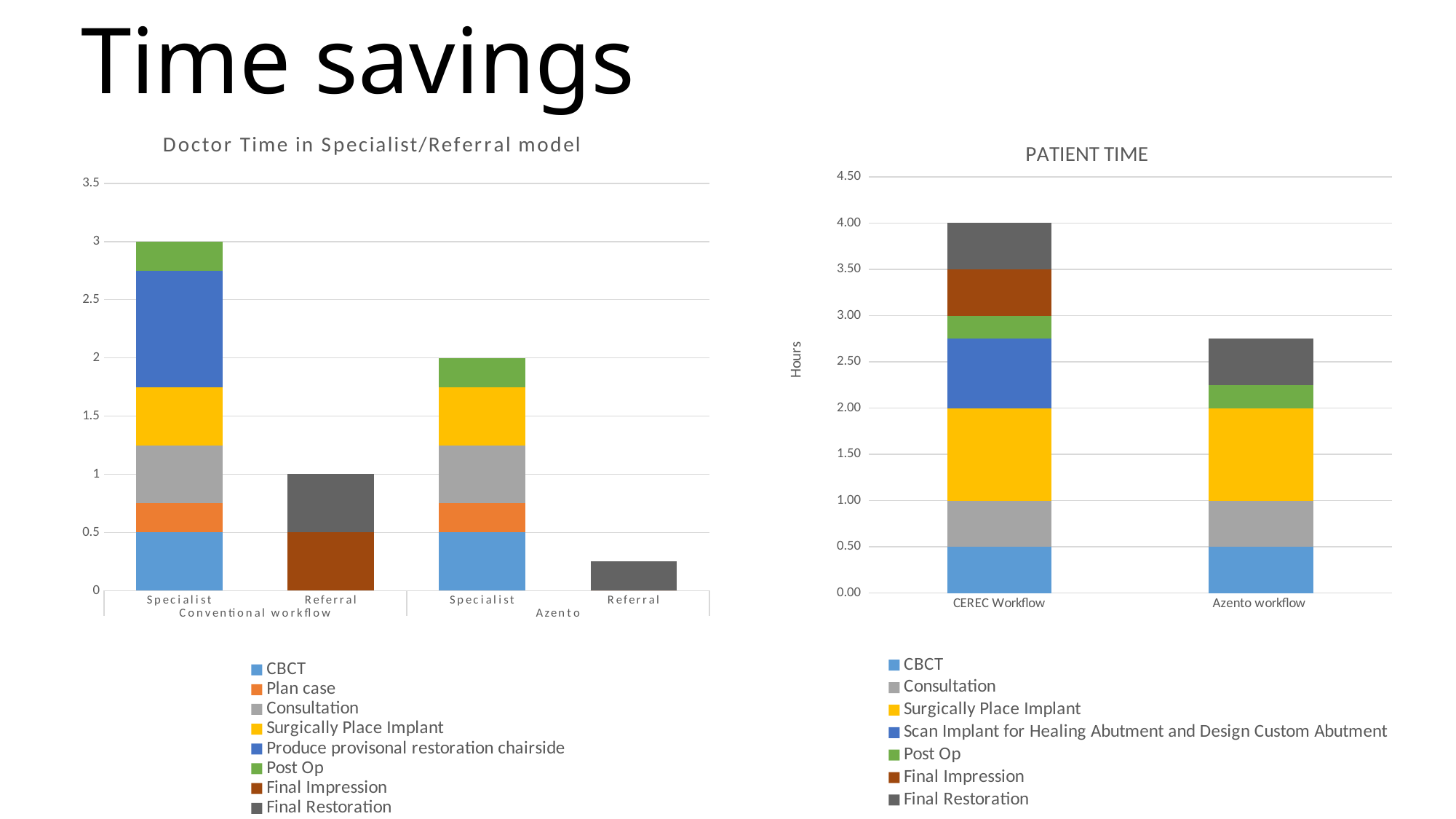
In the 'Doctor Time in Specialist/Referral model' chart, is the Referral bar under Azento greater or less than 0.5? less How many series does the legend of the 'Doctor Time in Specialist/Referral model' chart list? 8 How many series does the legend of the 'PATIENT TIME' chart list? 7 In the 'PATIENT TIME' chart, is the total for Azento workflow greater or less than 2.50? greater In the 'Doctor Time in Specialist/Referral model' chart, what is the total height of the Specialist bar under Conventional workflow? 3 How many bars are shown in the 'Doctor Time in Specialist/Referral model' chart? 4 In the 'PATIENT TIME' chart, which workflow has the taller bar? CEREC Workflow In the 'Doctor Time in Specialist/Referral model' chart, which bar is the shortest? Referral under Azento What kind of chart is the 'Doctor Time in Specialist/Referral model' chart? Stacked bar chart In the 'Doctor Time in Specialist/Referral model' chart, which is larger: the Specialist bar under Conventional workflow or the Specialist bar under Azento? Specialist under Conventional workflow What is the y-axis label of the 'PATIENT TIME' chart? Hours In the 'PATIENT TIME' chart, what is the total height of the CEREC Workflow bar? 4.00